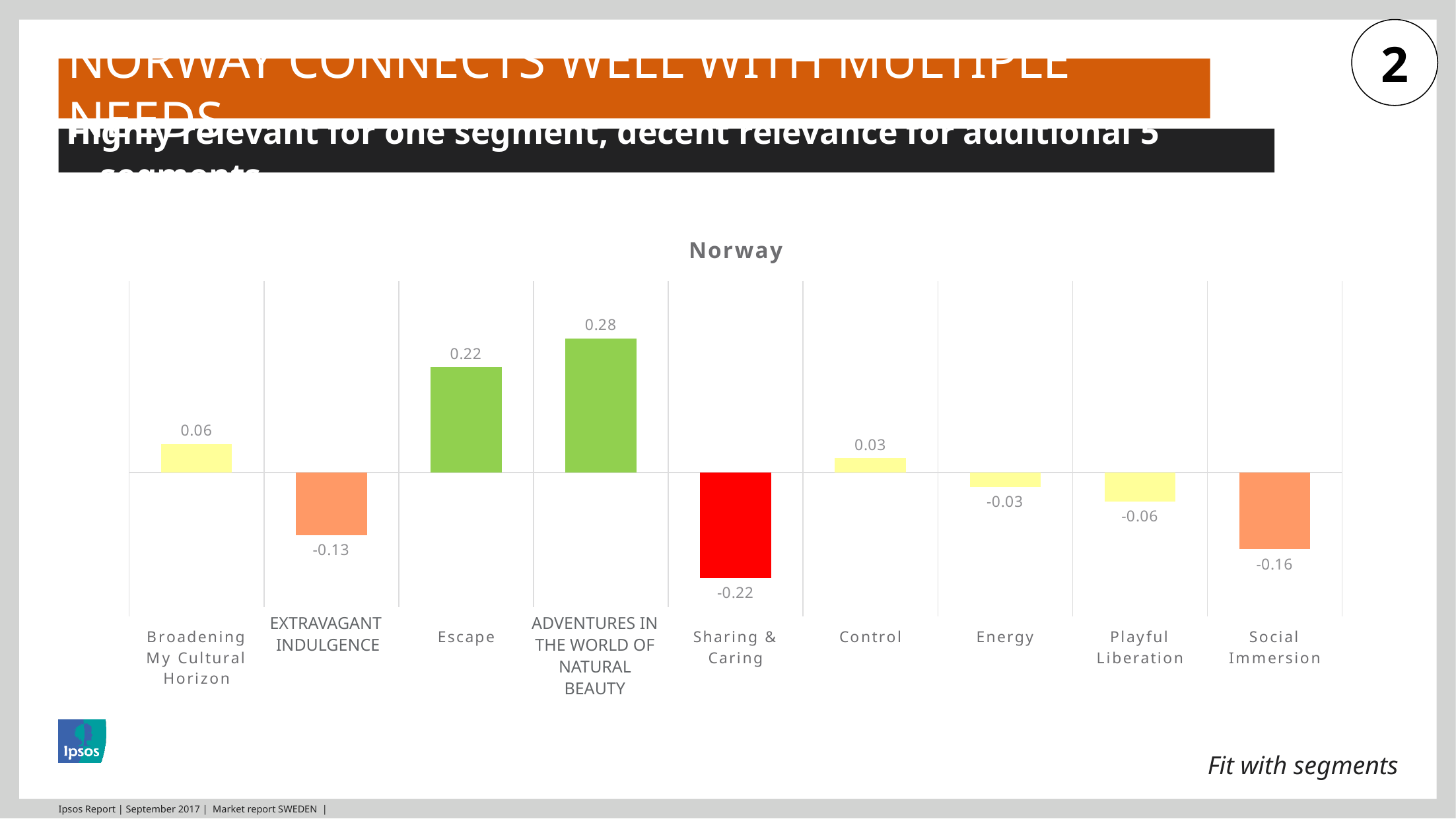
What is the value for Control in the Norway chart? 0.03 What is the difference between the values for Broadening My Cultural Horizon and Control in the Norway chart? 0.03 Which has a larger value in the Norway chart, EXTRAVAGANT INDULGENCE or Social Immersion? EXTRAVAGANT INDULGENCE What is the value for Sharing & Caring in the Norway chart? -0.22 What is the value for Social Immersion in the Norway chart? -0.16 What is the value for Escape in the Norway chart? 0.22 What is the title of the chart on the slide? Norway Which category has the lowest value in the Norway chart? Sharing & Caring Which category has the highest value in the Norway chart? ADVENTURES IN THE WORLD OF NATURAL BEAUTY How many categories are shown in the Norway chart? 9 What is the difference between the values for ADVENTURES IN THE WORLD OF NATURAL BEAUTY and Escape in the Norway chart? 0.06 What type of chart is shown on the slide? Bar chart